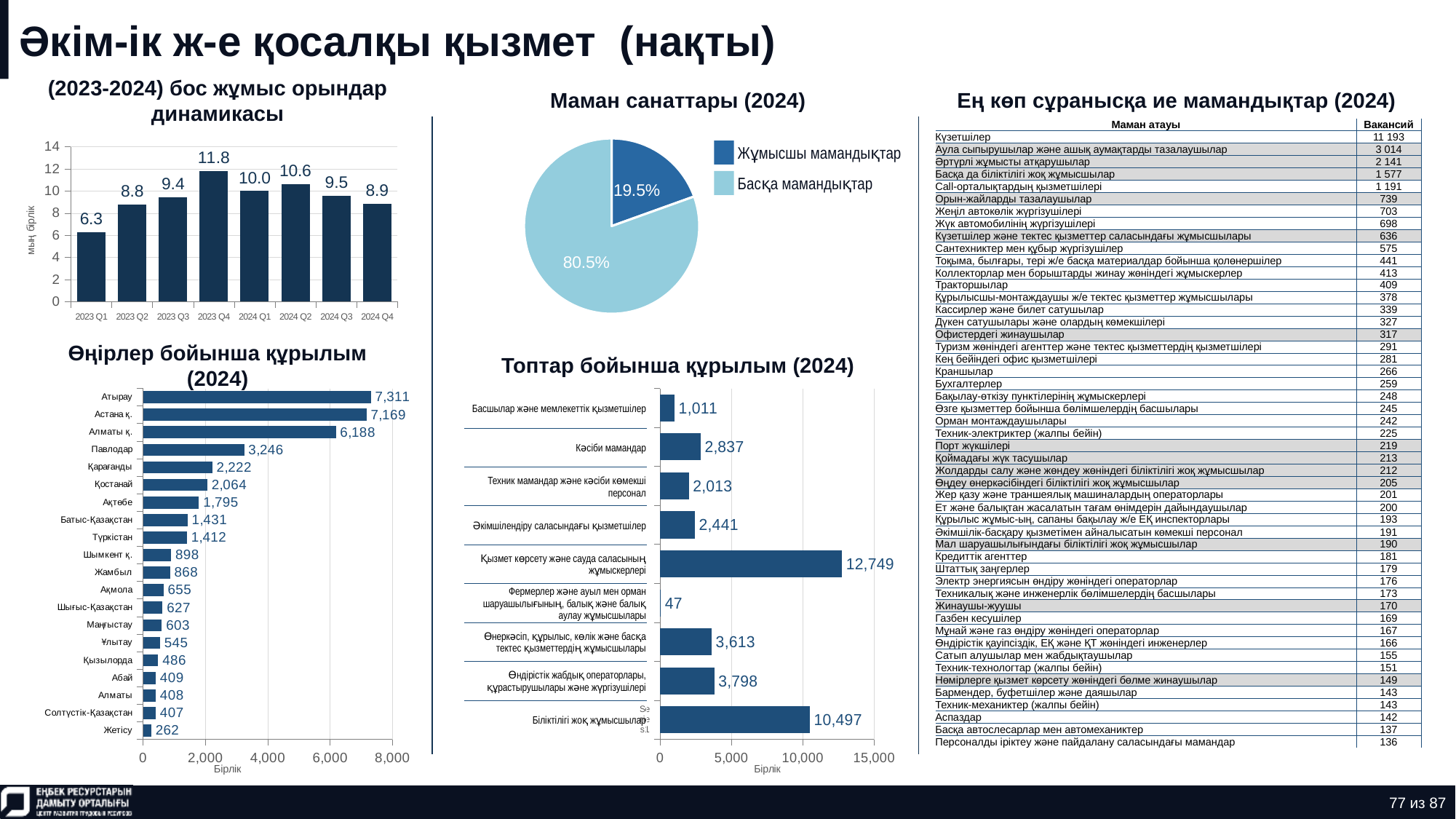
In the chart "Өңірлер бойынша құрылым (2024)", what is the value for Павлодар? 3,246 In the chart "(2023-2024) бос жұмыс орындар динамикасы", what is the value for 2023 Q4? 11.8 In the chart "(2023-2024) бос жұмыс орындар динамикасы", what is the difference between 2024 Q2 and 2024 Q4? 1.7 In the pie chart "Маман санаттары (2024)", how many entries does the legend list? 2 In the chart "Өңірлер бойынша құрылым (2024)", which region has the highest value? Атырау In the chart "Топтар бойынша құрылым (2024)", what is the value for "Қызмет көрсету және сауда саласының жұмыскерлері"? 12,749 What kind of chart is "Топтар бойынша құрылым (2024)"? Bar chart In the pie chart "Маман санаттары (2024)", what share does "Басқа мамандықтар" have? 80.5% In the chart "Өңірлер бойынша құрылым (2024)", what is the value for Жетісу? 262 In the chart "(2023-2024) бос жұмыс орындар динамикасы", how many quarters are plotted? 8 In the chart "(2023-2024) бос жұмыс орындар динамикасы", which quarter has the lowest value? 2023 Q1 In the chart "Өңірлер бойынша құрылым (2024)", which is larger, Астана қ. or Алматы қ.? Астана қ.